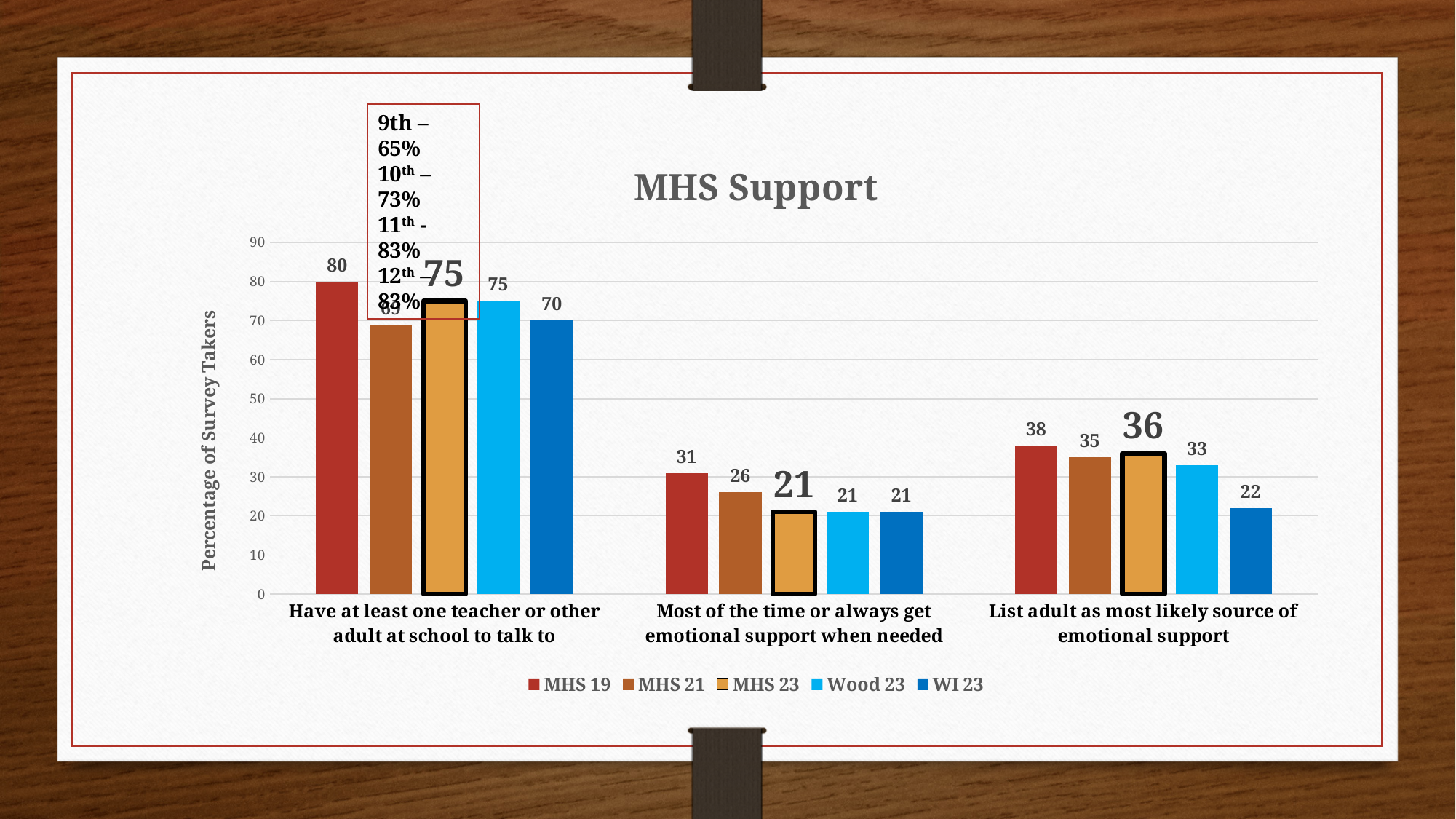
What is the value for WI 23 in the category 'List adult as most likely source of emotional support'? 22 What is the difference between MHS 19 and MHS 21 in the category 'Most of the time or always get emotional support when needed'? 5 How many categories are shown on the x axis? 3 What kind of chart is shown on the slide? Bar chart Which series has the lowest value in the category 'List adult as most likely source of emotional support'? WI 23 What is the value for MHS 23 in the category 'Most of the time or always get emotional support when needed'? 21 What is the label of the y axis? Percentage of Survey Takers How many series does the legend list? 5 Which is larger in the category 'Have at least one teacher or other adult at school to talk to': MHS 19 or WI 23? MHS 19 What is the title of the chart? MHS Support What is the value for MHS 19 in the category 'Have at least one teacher or other adult at school to talk to'? 80 Which series has the highest value in the category 'List adult as most likely source of emotional support'? MHS 19